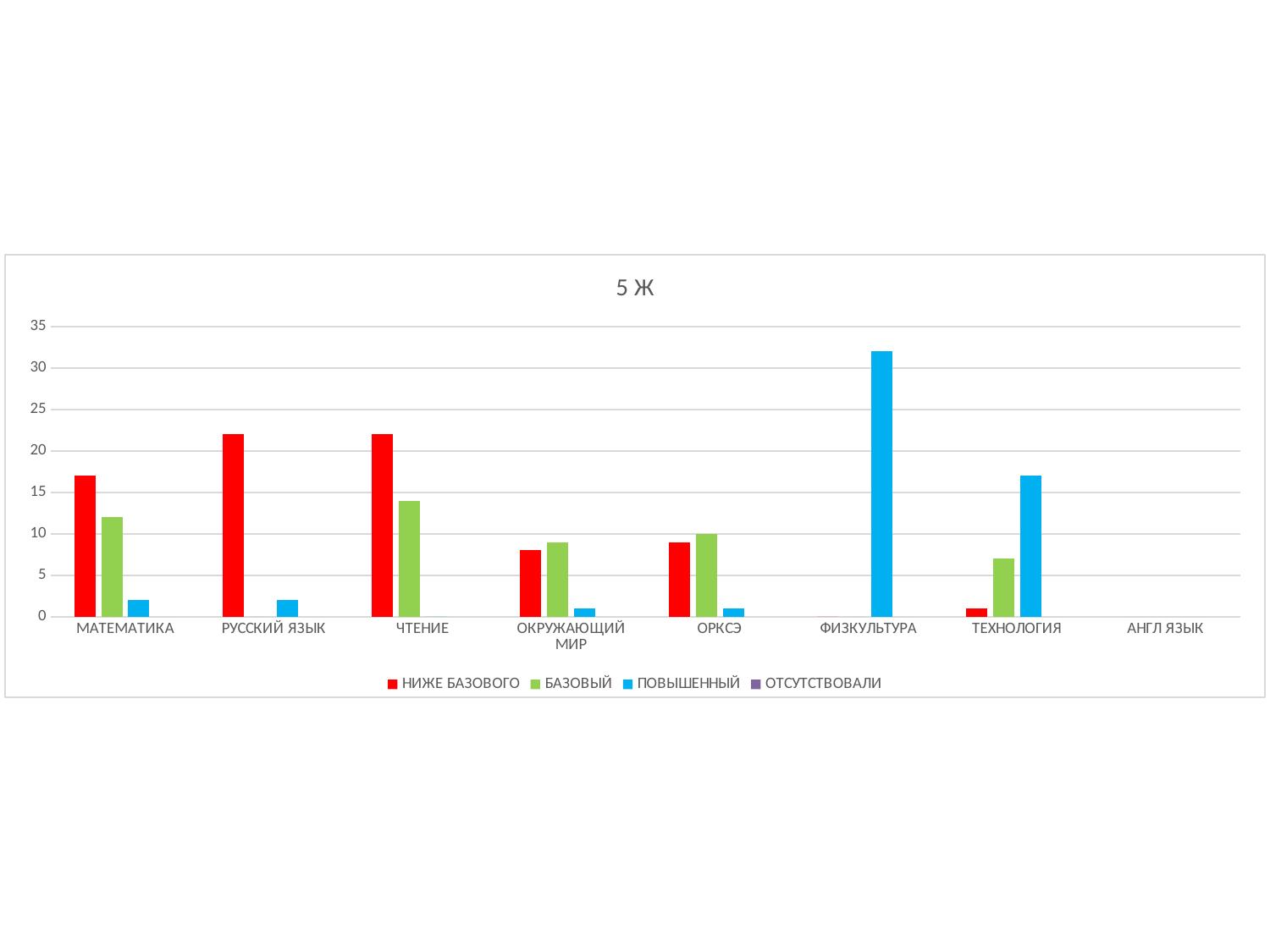
For МАТЕМАТИКА, which is larger: НИЖЕ БАЗОВОГО or БАЗОВЫЙ? НИЖЕ БАЗОВОГО Which category has the highest value for the ПОВЫШЕННЫЙ series? ФИЗКУЛЬТУРА Which category has the highest value for the БАЗОВЫЙ series? ЧТЕНИЕ Is the НИЖЕ БАЗОВОГО value for ОКРУЖАЮЩИЙ МИР greater or less than 10? less For ТЕХНОЛОГИЯ, which is larger: ПОВЫШЕННЫЙ or БАЗОВЫЙ? ПОВЫШЕННЫЙ How many subject categories are shown on the x axis? 8 How many series does the legend list? 4 What kind of chart is shown on the slide? bar chart Is the НИЖЕ БАЗОВОГО value for РУССКИЙ ЯЗЫК greater or less than 20? greater Which category has the tallest bar in the chart? ФИЗКУЛЬТУРА What is the title of the chart? 5 Ж Is the ПОВЫШЕННЫЙ value for ФИЗКУЛЬТУРА greater or less than 30? greater